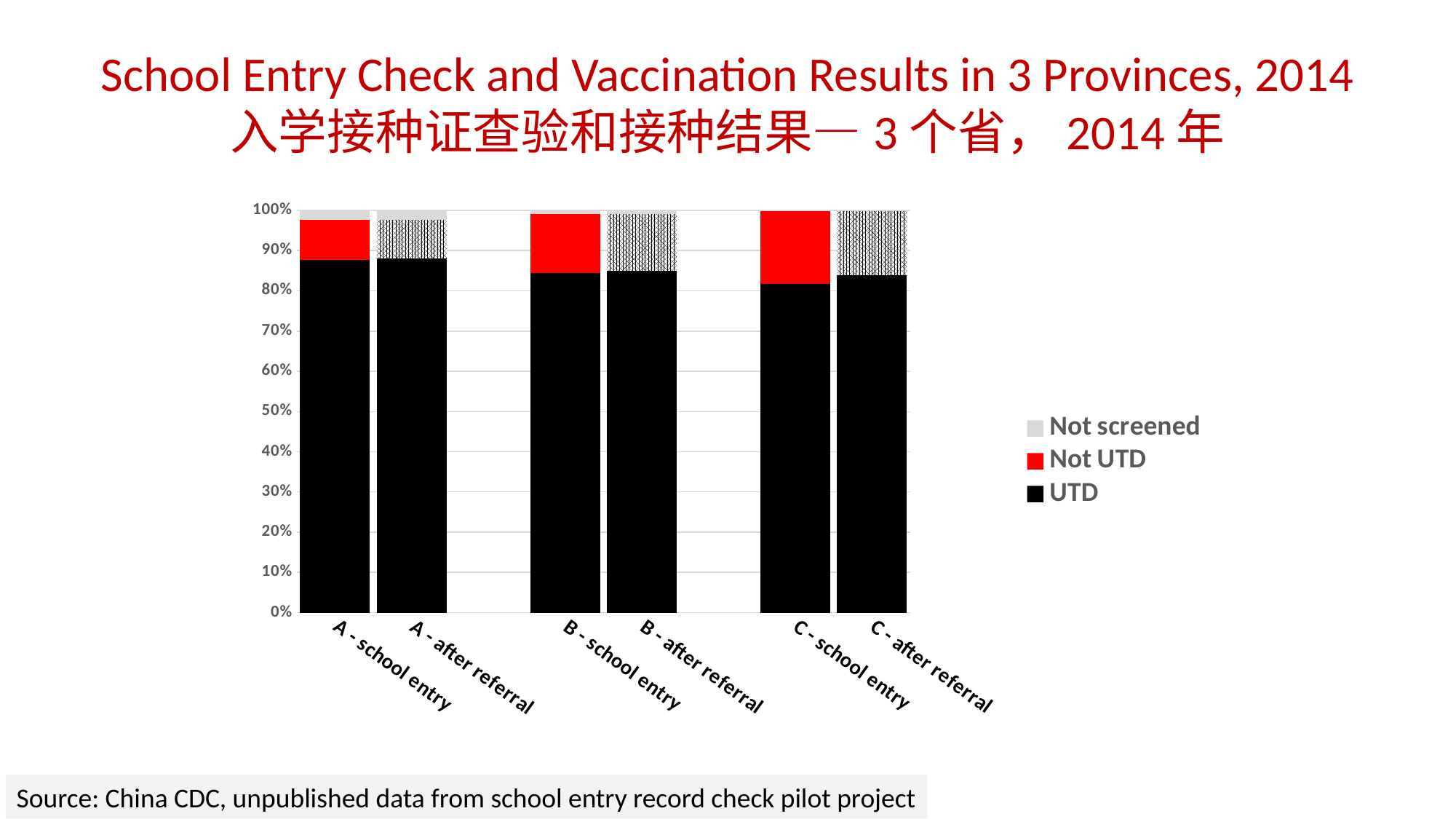
Which category has the largest Not UTD share? C - school entry Is the UTD value for C - school entry greater or less than 90%? less Which has a larger UTD value, A - school entry or C - school entry? A - school entry Which colour represents the UTD series in the chart? Black Which series are listed in the chart's legend? Not screened, Not UTD, UTD How many categories are plotted along the x axis of the chart? 6 What kind of chart is shown on the slide? Stacked bar chart Which category has the lowest UTD value? C - school entry Is the Not UTD share for C - school entry greater or less than 10%? greater Is the UTD value for A - school entry greater or less than 80%? greater How many series does the chart's legend list? 3